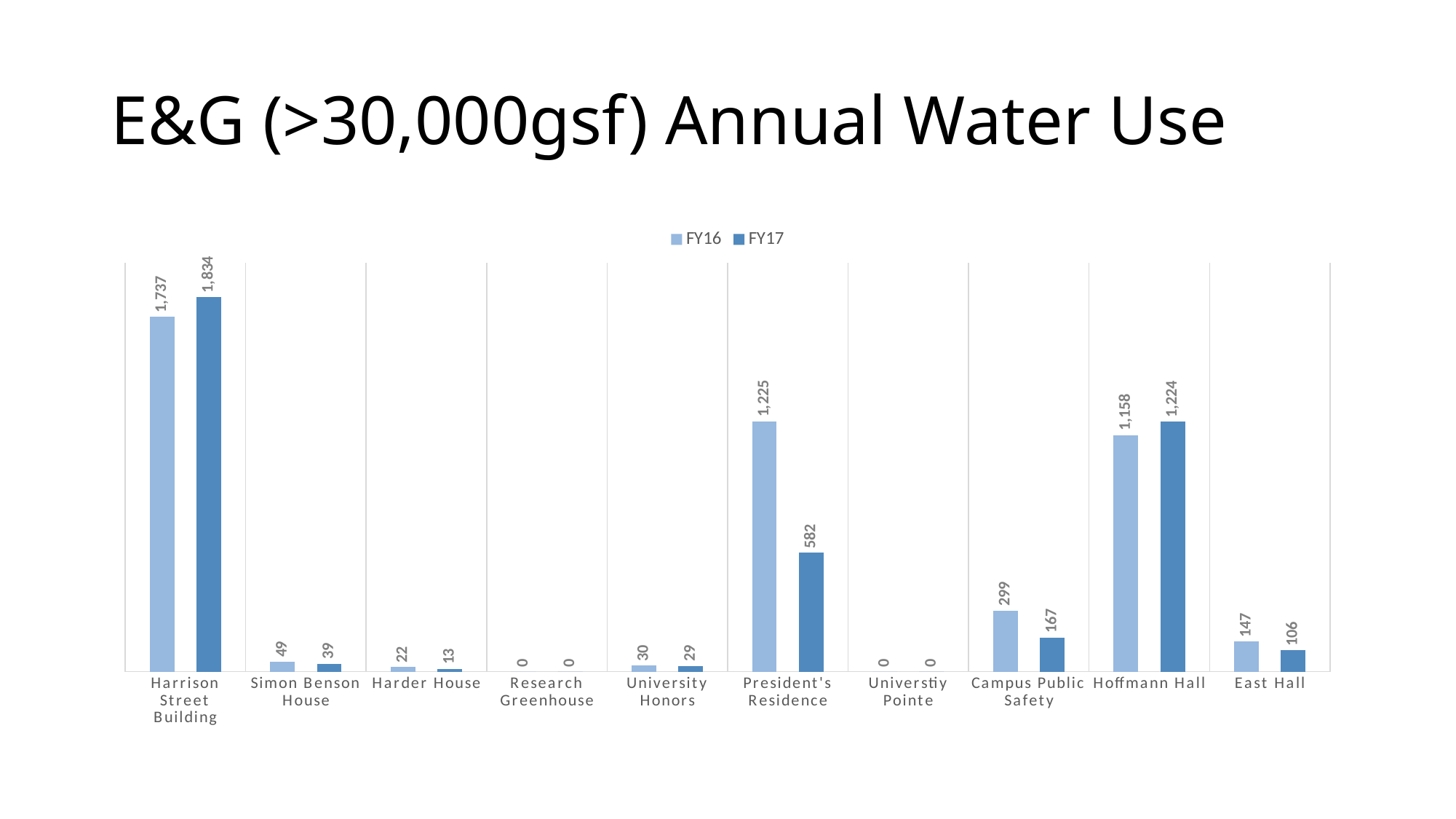
Which building has the highest FY16 value? Harrison Street Building What is the difference between the FY16 and FY17 values for President's Residence? 643 Which building has the lowest FY17 value among those with a non-zero value? Harder House What is the difference between the FY16 and FY17 values for East Hall? 41 What is the FY16 value for President's Residence? 1,225 What is the FY17 value for Campus Public Safety? 167 What is the FY17 value for Harrison Street Building? 1,834 Is the FY16 value for Hoffmann Hall larger or smaller than its FY17 value? smaller What kind of chart is shown on the slide? bar chart How many buildings are shown on the x axis? 10 What is the title of the slide? E&G (>30,000gsf) Annual Water Use How many series does the legend list? 2